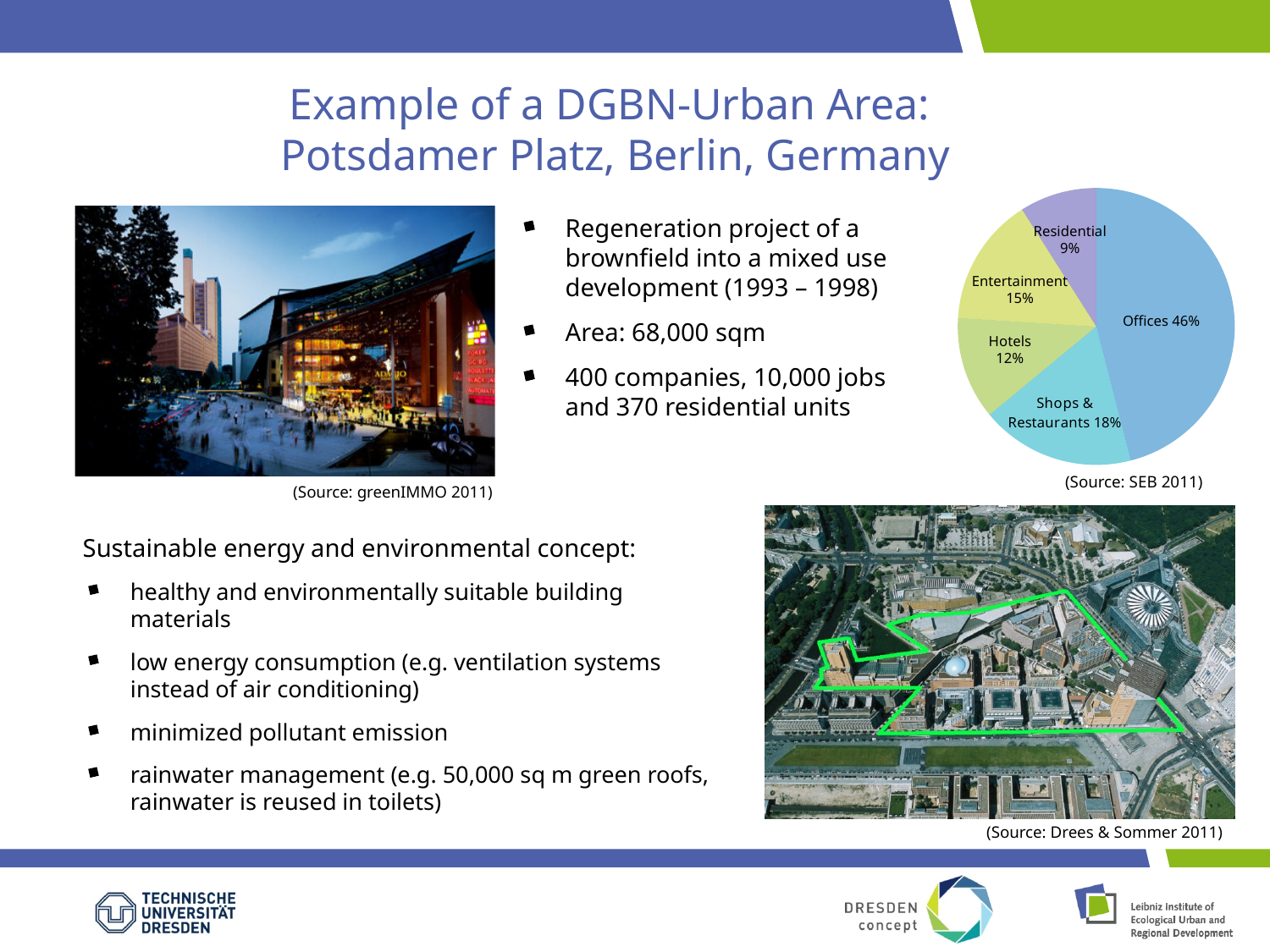
Which category has the largest slice of the pie chart? Offices What share of the pie chart is Residential? 9% What share of the pie chart is Hotels? 12% Which category has the smallest slice of the pie chart? Residential What source is cited below the pie chart? SEB 2011 How many slices does the pie chart have? 5 What kind of chart is shown on the slide? pie chart What share of the pie chart is Offices? 46% Which is larger in the pie chart, Entertainment or Hotels? Entertainment What share of the pie chart is Entertainment? 15% What share of the pie chart is Shops & Restaurants? 18% What is the difference in percentage points between Offices and Shops & Restaurants? 28